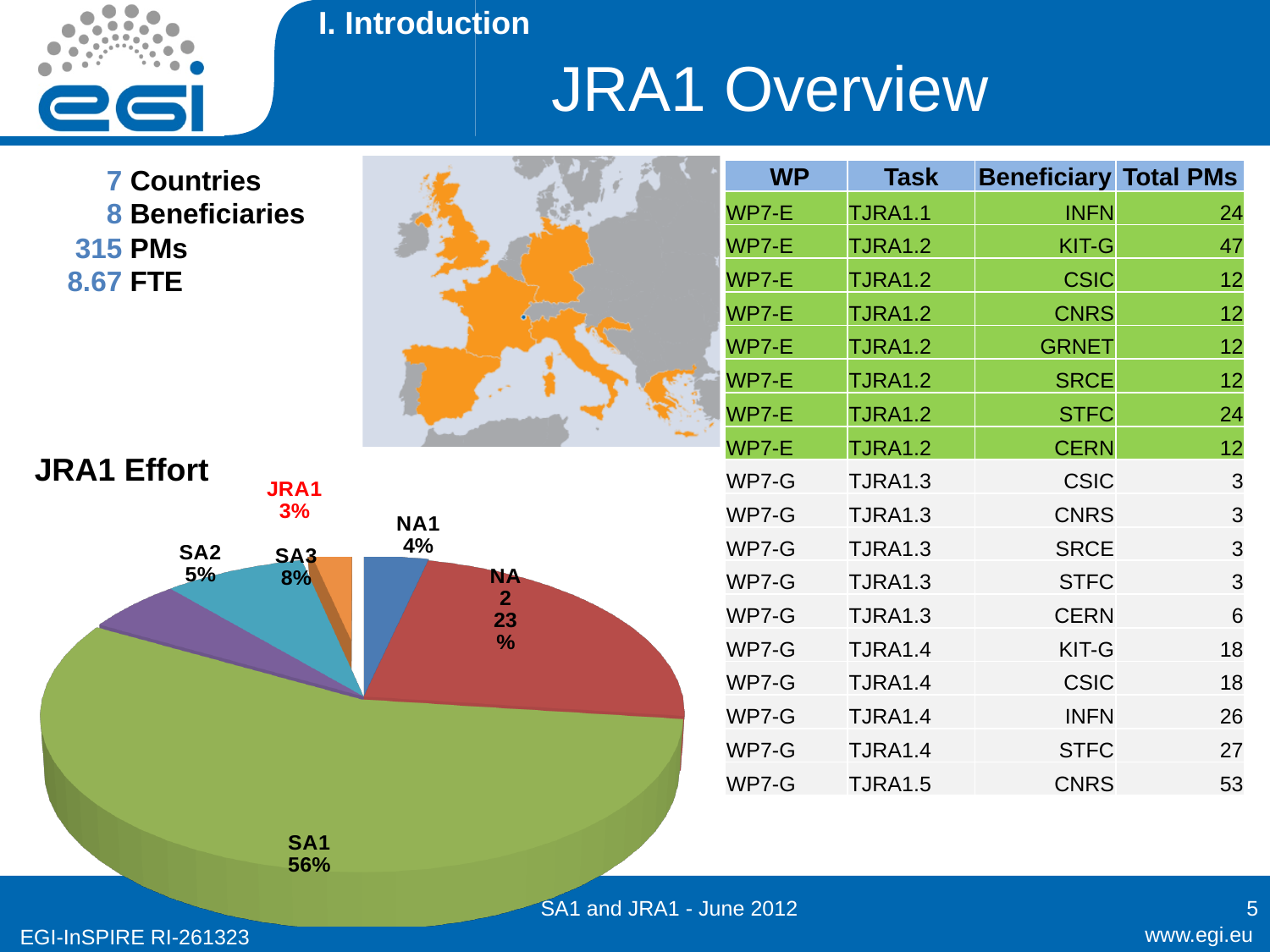
What kind of chart is the JRA1 Effort chart? pie chart What share of JRA1 Effort does SA1 account for? 56% Which slice is the largest in the JRA1 Effort pie chart? SA1 What percentage is shown for JRA1 in the JRA1 Effort pie chart? 3% What percentage is shown for NA2 in the JRA1 Effort pie chart? 23% Which slice is the smallest in the JRA1 Effort pie chart? JRA1 In the JRA1 Effort pie chart, which is larger, SA3 or SA2? SA3 In the JRA1 Effort pie chart, what is the combined share of NA1 and SA2? 9% In the JRA1 Effort pie chart, what is the difference in percentage points between SA1 and NA2? 33 How many slices does the JRA1 Effort pie chart have? 6 What is the title of the pie chart on the slide? JRA1 Effort What percentage is shown for SA3 in the JRA1 Effort pie chart? 8%